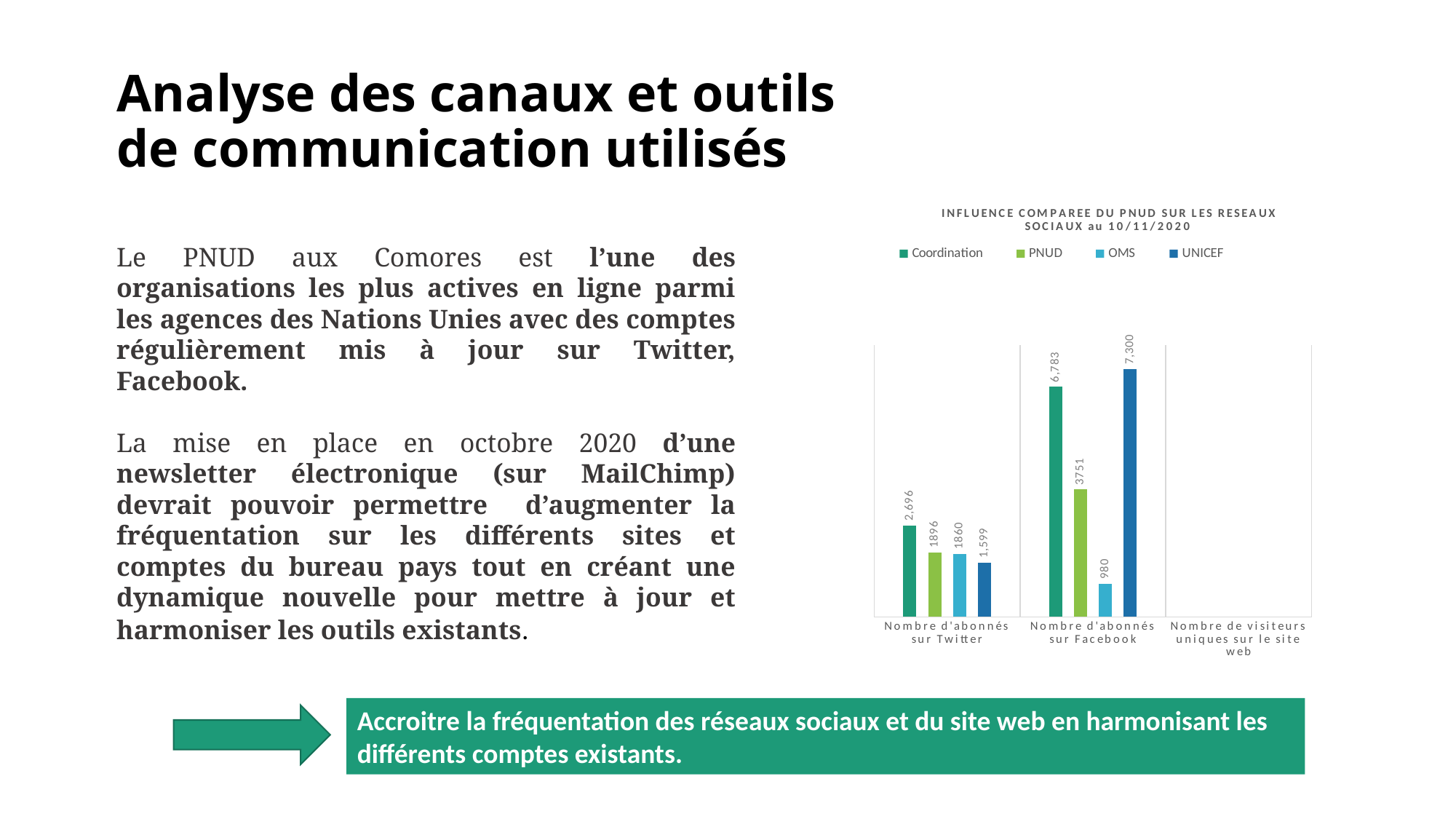
What is the number of Facebook followers (Nombre d'abonnés sur Facebook) for UNICEF? 7,300 What is the number of Twitter followers (Nombre d'abonnés sur Twitter) for Coordination? 2,696 What is the number of Facebook followers for OMS? 980 Which organisation has the lowest number of Twitter followers? UNICEF Which organisation has the highest number of Facebook followers? UNICEF What is the difference between Coordination's and UNICEF's number of Twitter followers? 1,097 What is the title of the chart? INFLUENCE COMPAREE DU PNUD SUR LES RESEAUX SOCIAUX au 10/11/2020 What is the difference between UNICEF's and Coordination's number of Facebook followers? 517 Which is larger: PNUD's number of Facebook followers or OMS's number of Facebook followers? PNUD What is the number of Twitter followers for PNUD? 1896 What type of chart is shown on the slide? Bar chart How many series does the chart legend list? 4